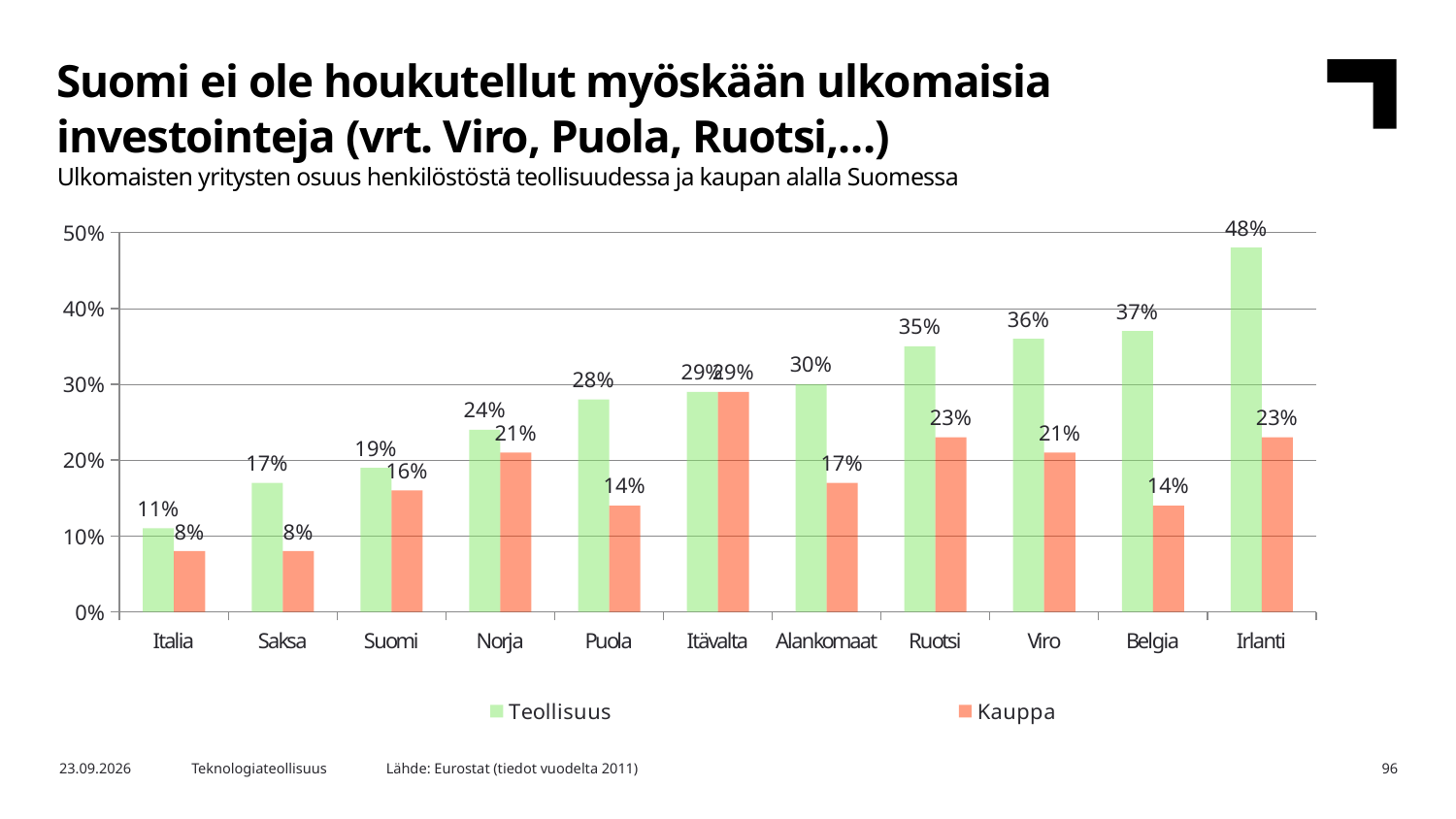
Which country has the highest Teollisuus value? Irlanti What is the Kauppa value for Ruotsi? 23% Which is larger, the Kauppa value for Norja or the Kauppa value for Belgia? Norja How many countries are shown on the x axis? 11 What is the difference between the Teollisuus and Kauppa values for Puola? 14% What is the Teollisuus value for Suomi? 19% Which country has the lowest Teollisuus value? Italia What kind of chart is shown on the slide? Bar chart How many series does the legend list? 2 What is the Teollisuus value for Viro? 36% Do the Teollisuus values rise or fall from Italia to Irlanti along the x axis? Rise What is the difference between the Teollisuus values for Irlanti and Suomi? 29%